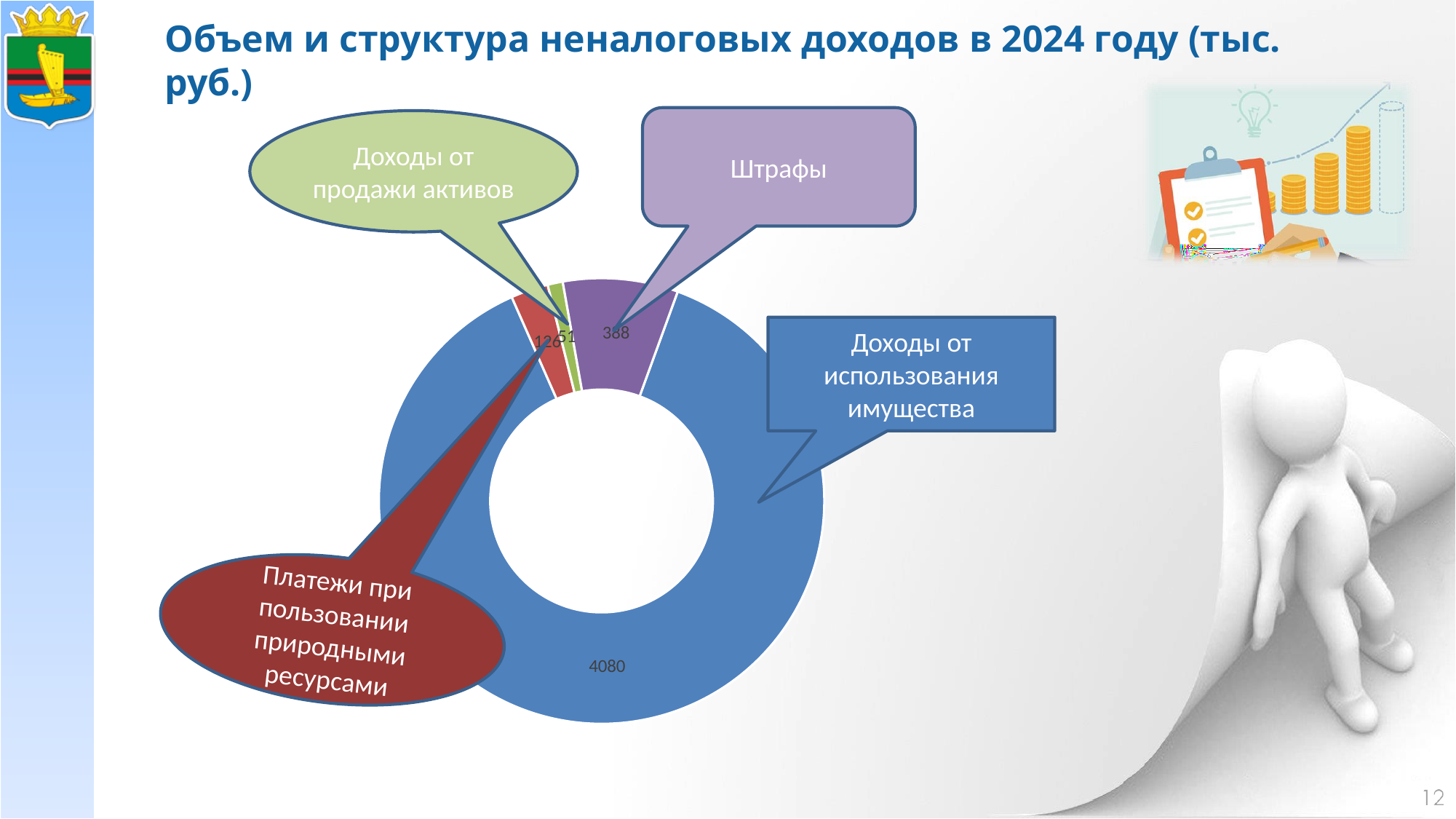
What is the difference between the values for Доходы от использования имущества and Штрафы? 3692 What is the total of all values shown in the chart? 4645 What is the title of the slide? Объем и структура неналоговых доходов в 2024 году (тыс. руб.) How many categories are shown in the chart? 4 What value is shown for Платежи при пользовании природными ресурсами? 126 What kind of chart is shown on the slide? Doughnut (pie) chart What value is shown for Доходы от использования имущества? 4080 What value is shown for Штрафы? 388 What value is shown for Доходы от продажи активов? 51 Which is larger: Штрафы or Платежи при пользовании природными ресурсами? Штрафы Which category has the smallest value in the chart? Доходы от продажи активов Which category has the largest value in the chart? Доходы от использования имущества